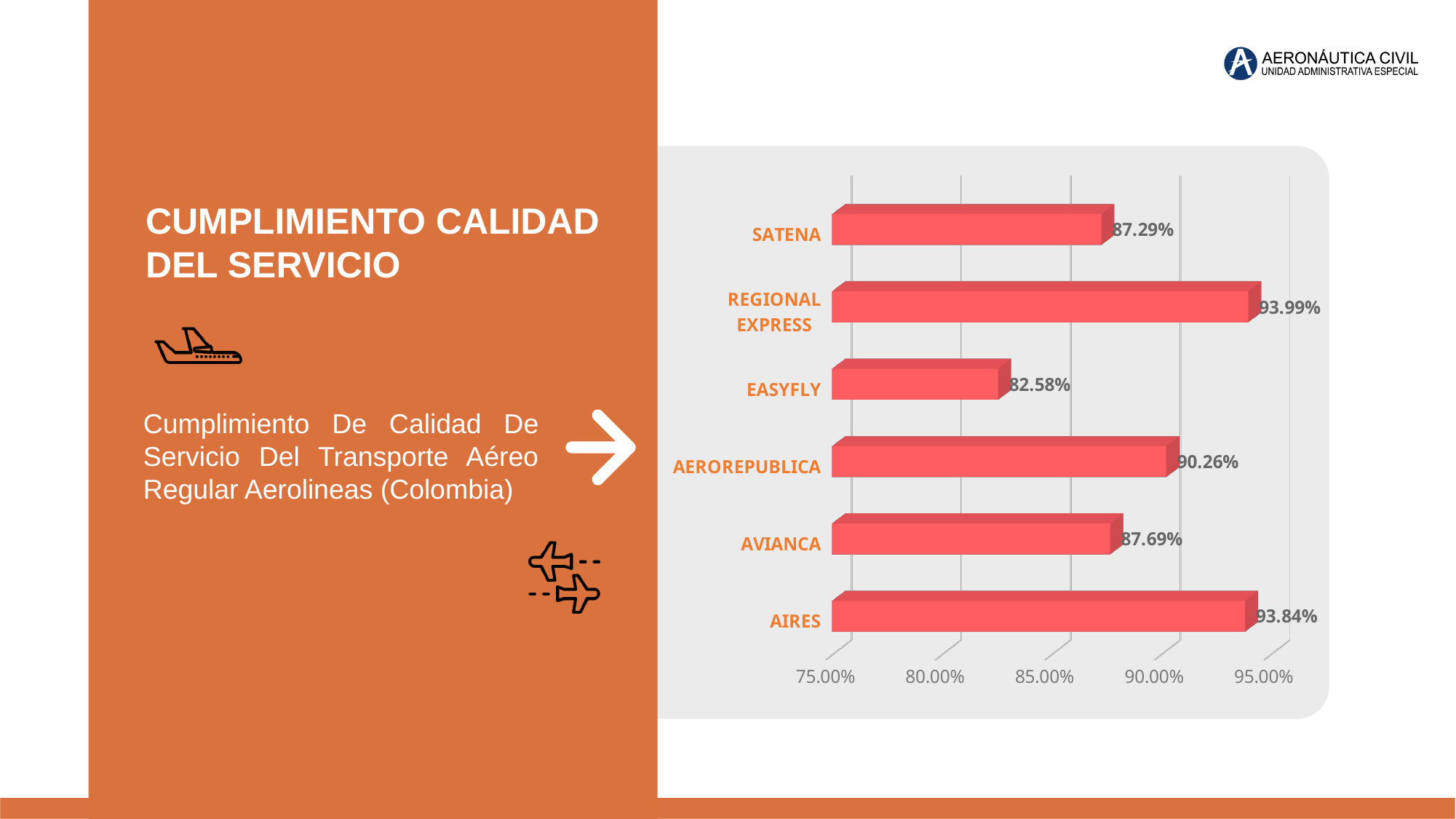
What is the difference between the values for AEROREPUBLICA and SATENA? 2.97% What is the value for SATENA? 87.29% Which airline has the lowest value? EASYFLY What is the value for AEROREPUBLICA? 90.26% How many airlines are shown in the chart? 6 Which airline has the highest value? REGIONAL EXPRESS What is the value for AIRES? 93.84% What is the value for EASYFLY? 82.58% What kind of chart is shown on the slide? bar chart What is the value for REGIONAL EXPRESS? 93.99% Is the value for EASYFLY greater or less than 85.00%? less Which is larger, the value for AVIANCA or the value for SATENA? AVIANCA